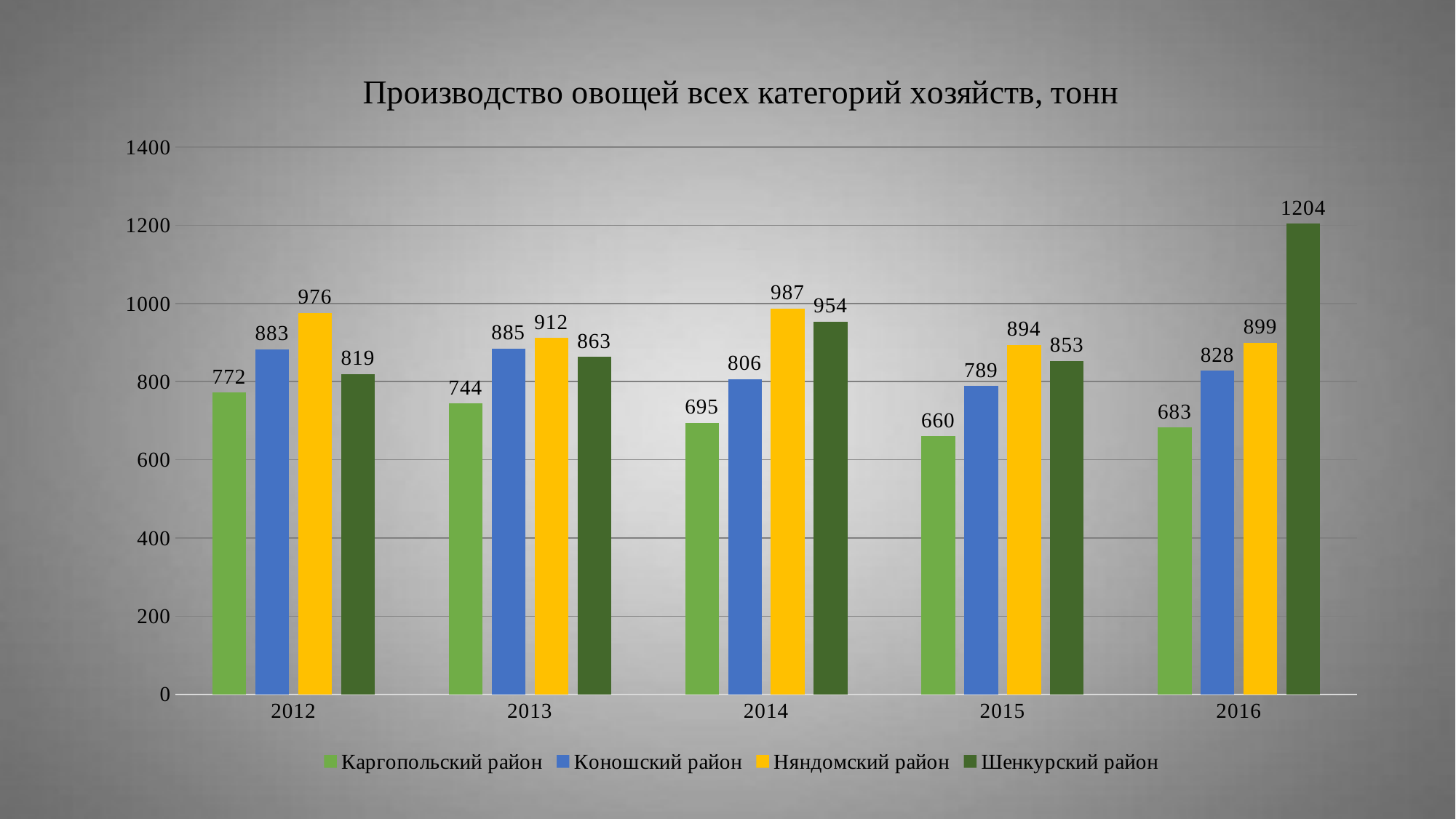
What is the difference between Няндомский район and Каргопольский район in 2012? 204 What is the value for Няндомский район in 2014? 987 Do the values for Каргопольский район rise or fall from 2012 to 2016? Fall Is the value for Шенкурский район in 2016 greater or less than 1000? greater Which district has the lowest value in 2015? Каргопольский район Which district has the highest value in 2016? Шенкурский район What is the value for Шенкурский район in 2016? 1204 What is the value for Каргопольский район in 2012? 772 Which is larger in 2013: Коношский район or Шенкурский район? Коношский район How many years are shown on the x axis? 5 What kind of chart is shown on the slide? Bar chart How many series does the legend list? 4